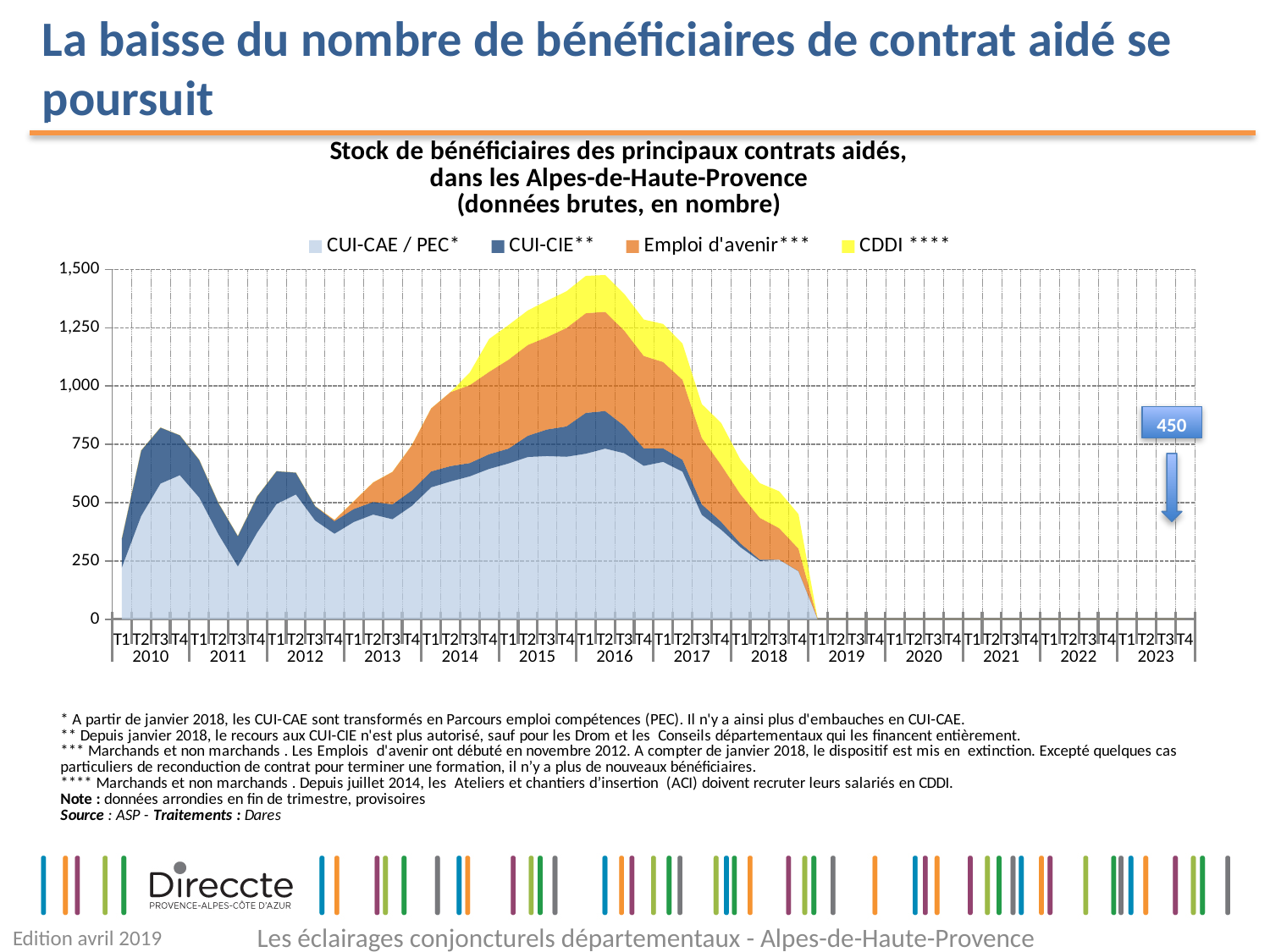
Is the total stacked value at T1 2010 greater or less than 500? less Which series is shown in yellow in the legend? CDDI **** In which year does the total stacked value reach its highest point? 2016 How many years are labelled on the x axis? 14 Is the total stacked value at T1 2018 greater or less than 500? greater What is the title of the chart? Stock de bénéficiaires des principaux contrats aidés, dans les Alpes-de-Haute-Provence (données brutes, en nombre) Does the total stacked value rise or fall between 2013 and 2016? rise What kind of chart is shown on the slide? Area chart Does the total stacked value rise or fall between 2016 and 2018? fall Which is larger, the total stacked value at T1 2016 or at T1 2010? T1 2016 Is the total stacked value at T1 2016 greater or less than 1,250? greater How many series does the legend list? 4